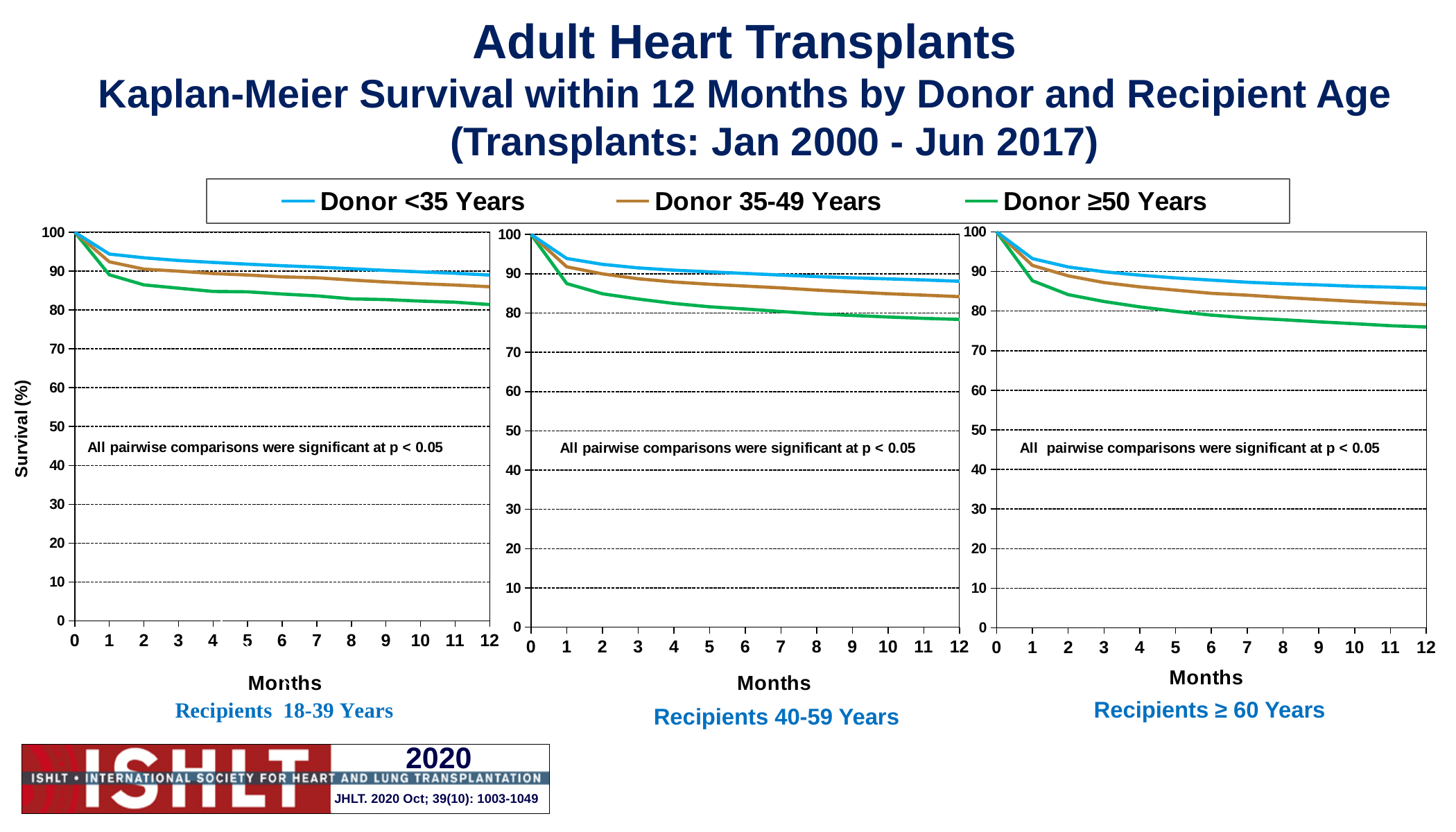
In the Recipients 40-59 Years chart, do the survival curves rise or fall as months increase? fall In the Recipients ≥ 60 Years chart, which donor age group has the highest survival at 12 months? Donor <35 Years In the Recipients 18-39 Years chart, which donor age group has the lowest survival at 12 months? Donor ≥50 Years What are the three series named in the legend? Donor <35 Years, Donor 35-49 Years, Donor ≥50 Years In the Recipients 40-59 Years chart, which has higher survival at 12 months: Donor <35 Years or Donor ≥50 Years? Donor <35 Years How many series does the legend list? 3 What kind of chart is used in the Recipients 18-39 Years panel? line chart In the Recipients 18-39 Years chart, what is the survival value for Donor <35 Years at 0 months? 100 How many charts are shown on the slide? 3 In the Recipients ≥ 60 Years chart, is the survival value for Donor ≥50 Years at 12 months greater or less than 80? less In the Recipients 40-59 Years chart, is the survival value for Donor <35 Years at 12 months greater or less than 80? greater In the Recipients 18-39 Years chart, is the survival value for Donor ≥50 Years at 12 months greater or less than 90? less